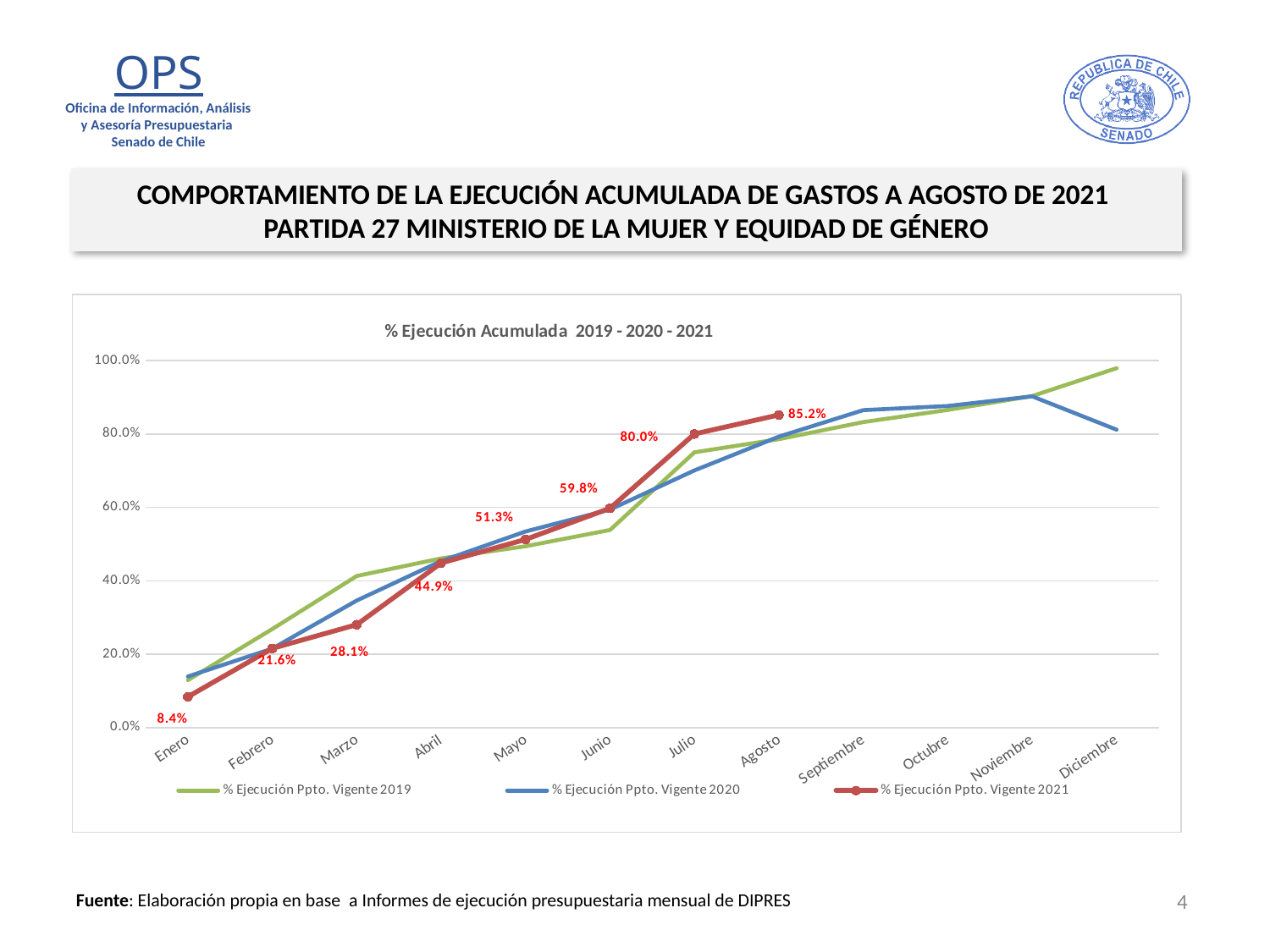
What type of chart is shown on the slide? Line chart How many series does the legend list? 3 Does the % Ejecución Ppto. Vigente 2021 line rise or fall from Enero to Agosto? Rise What is the value for % Ejecución Ppto. Vigente 2021 in Enero? 8.4% What is the value for % Ejecución Ppto. Vigente 2021 in Abril? 44.9% Which month has the highest value for % Ejecución Ppto. Vigente 2021? Agosto How many months are shown on the x axis? 12 Which month has the lowest value for % Ejecución Ppto. Vigente 2021? Enero What is the title of the chart? % Ejecución Acumulada 2019 - 2020 - 2021 Is the value for % Ejecución Ppto. Vigente 2019 in Diciembre greater or less than 80.0%? greater What is the value for % Ejecución Ppto. Vigente 2021 in Agosto? 85.2% What is the difference between the % Ejecución Ppto. Vigente 2021 values for Julio and Junio? 20.2%